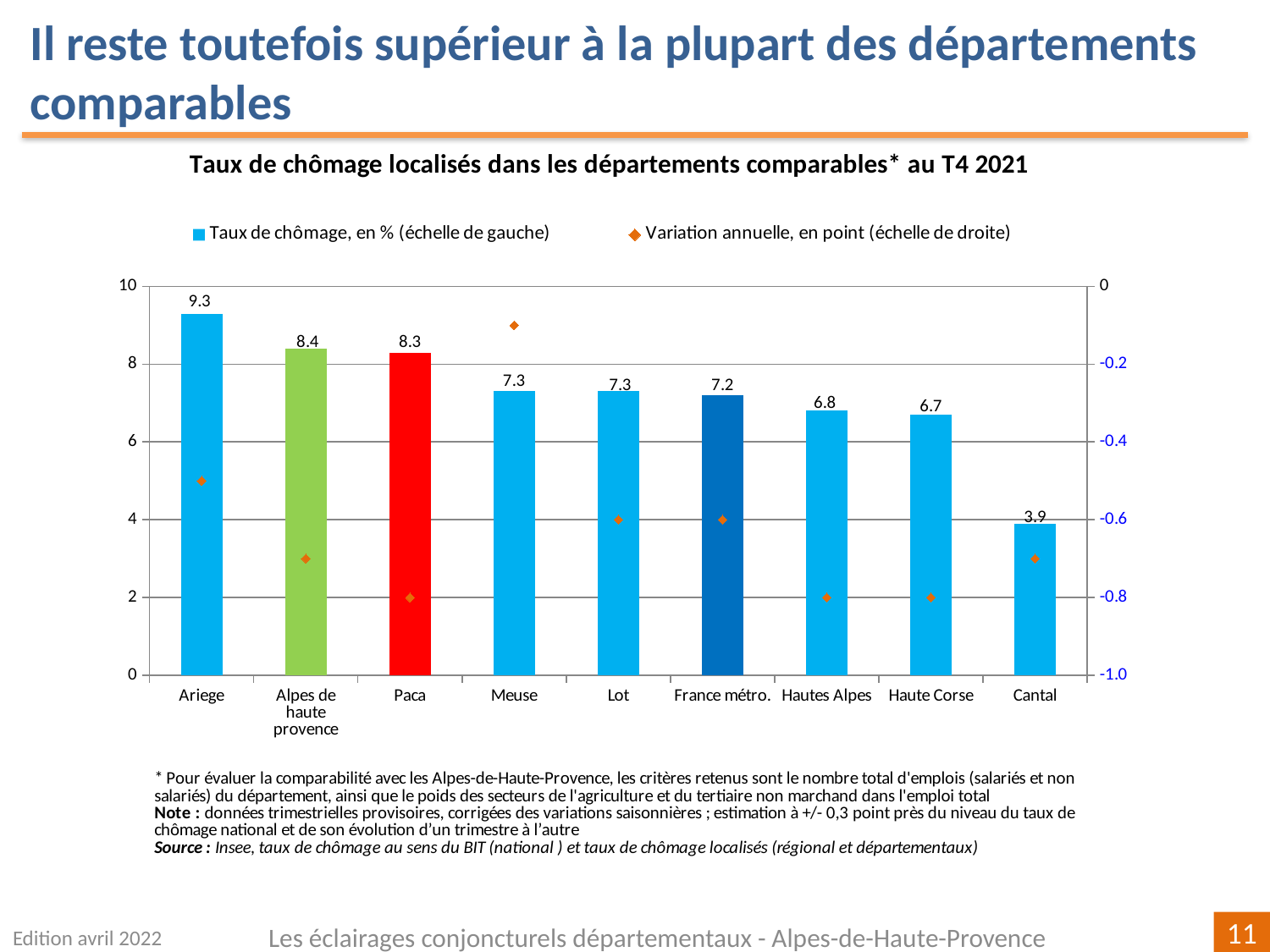
Is the annual variation (Variation annuelle) for Meuse greater or less than -0.2? greater Is the annual variation (Variation annuelle) for Ariege greater or less than -0.4? less How many series does the legend list? 2 What is the unemployment rate (Taux de chômage) shown for Ariege? 9.3 How many categories are shown on the x axis of the chart? 9 Which department has the highest unemployment rate on the chart? Ariege Which category has the lowest unemployment rate on the chart? Cantal What is the unemployment rate shown for Cantal? 3.9 Which has a higher unemployment rate, Hautes Alpes or France métro.? France métro. What type of chart is used to show the unemployment rates? Bar chart What is the difference between the unemployment rates of Ariege and Paca? 1.0 What is the unemployment rate shown for Alpes de haute provence? 8.4